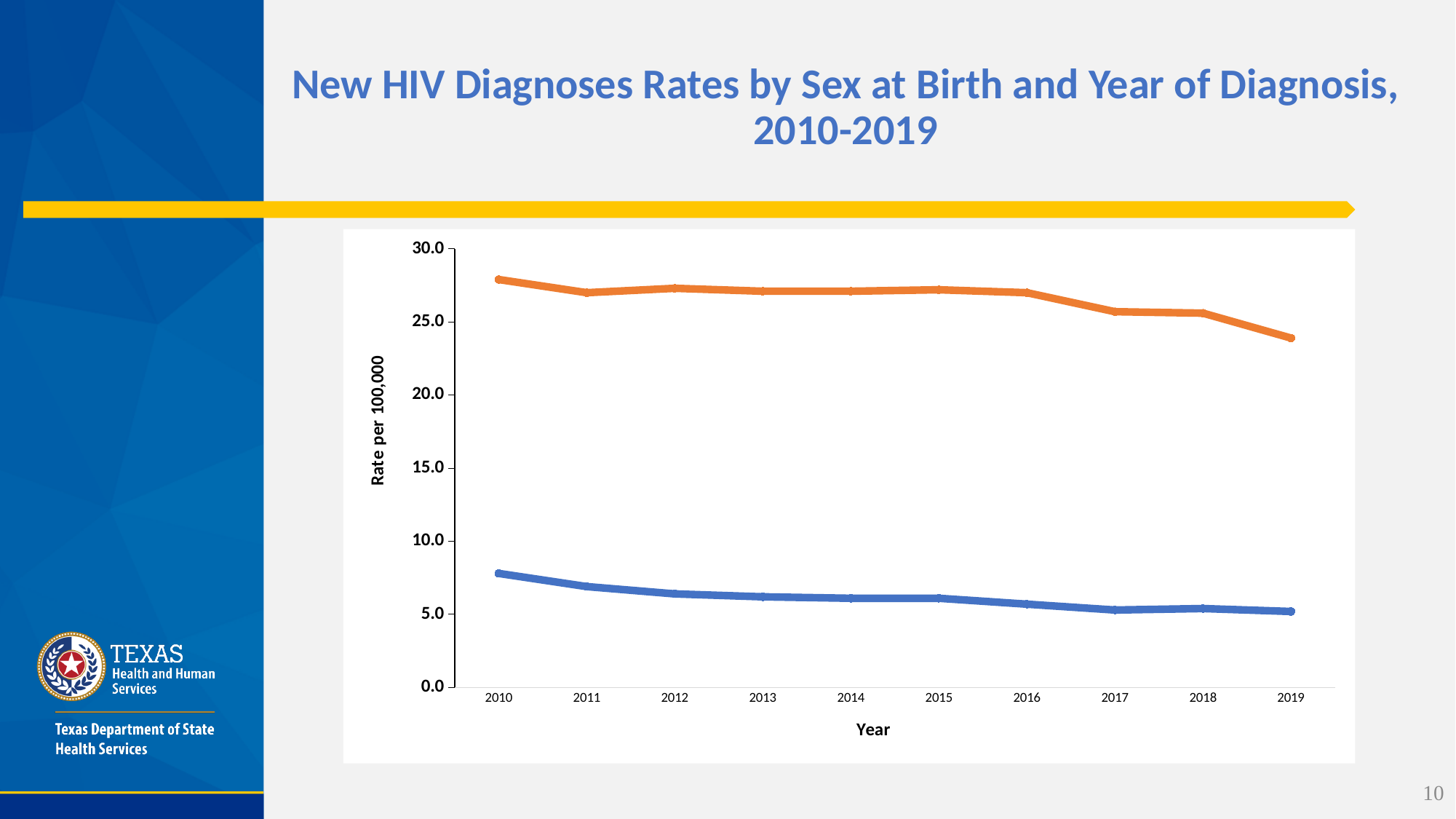
In which year is the orange line at its highest? 2010 What type of chart is shown on the slide? Line chart How many years are shown along the x axis? 10 Does the blue line rise or fall from 2010 to 2019? Fall Which line has the higher values throughout, the orange line or the blue line? Orange line In which year is the orange line at its lowest? 2019 What is the title of the chart on the slide? New HIV Diagnoses Rates by Sex at Birth and Year of Diagnosis, 2010-2019 Is the value of the blue line in 2010 greater or less than 5.0? greater Does the orange line rise or fall from 2010 to 2019? Fall What is the label of the vertical axis? Rate per 100,000 How many lines are plotted on the chart? 2 Is the value of the orange line in 2010 greater or less than 25.0? greater